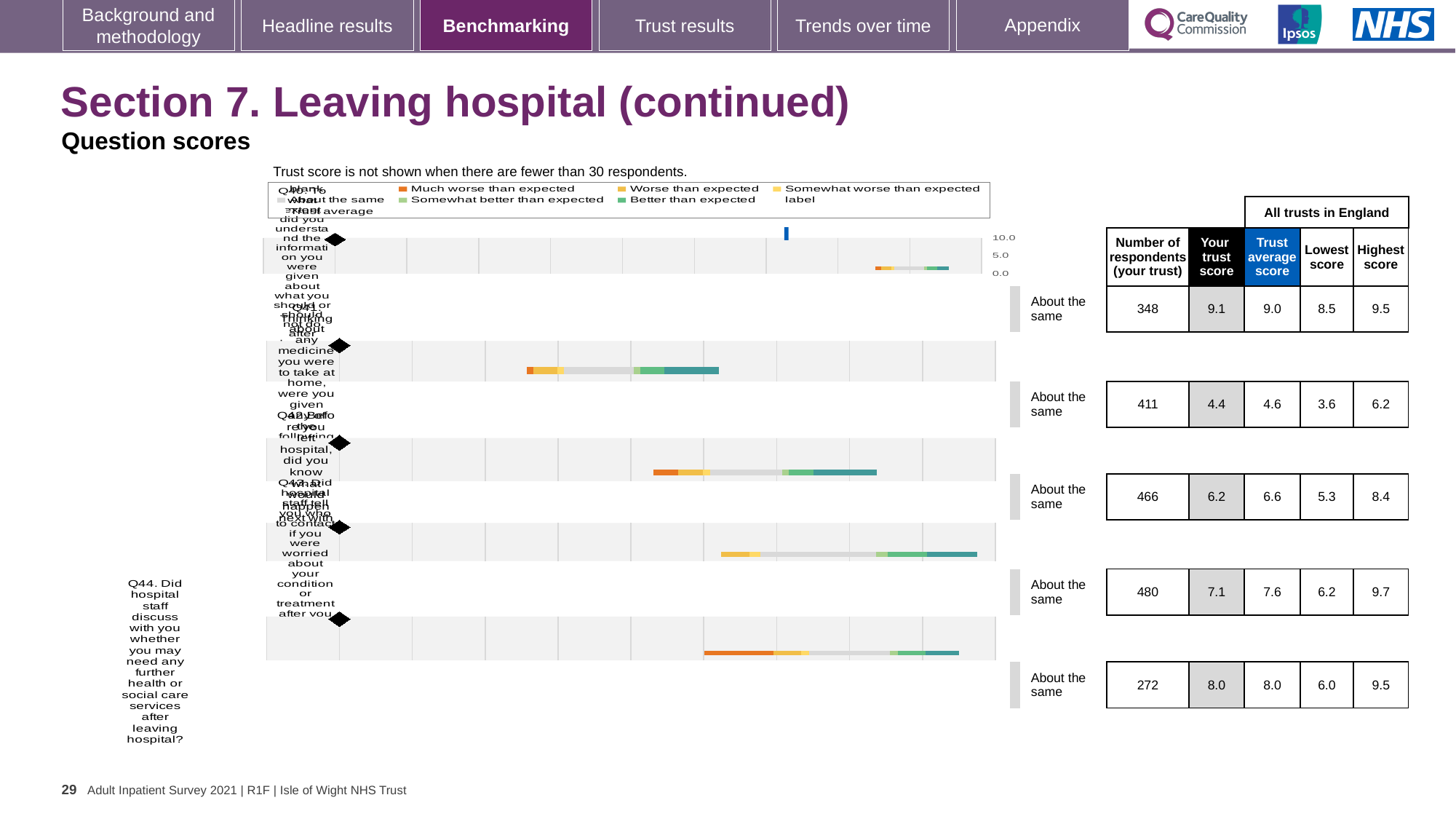
What kind of chart is shown on the slide? bar chart What is the trust score for the first (top) question row? 9.1 Which question row has the lowest trust score? the second row (4.4) Is the trust score for the third question row larger or smaller than the trust average score for that row? smaller What is the difference between the trust average score and the trust score for the fourth question row? 0.5 What is the trust average score for the second question row? 4.6 What is the highest score across all trusts in England for Q44 (the bottom row)? 9.5 How many question rows are shown in the benchmarking chart? 5 Which question row has the highest number of respondents? the fourth row (480) What is the number of respondents for Q44 (the bottom row)? 272 What benchmark category is shown for every question row on the slide? About the same What is the trust score for Q44 (the bottom row)? 8.0